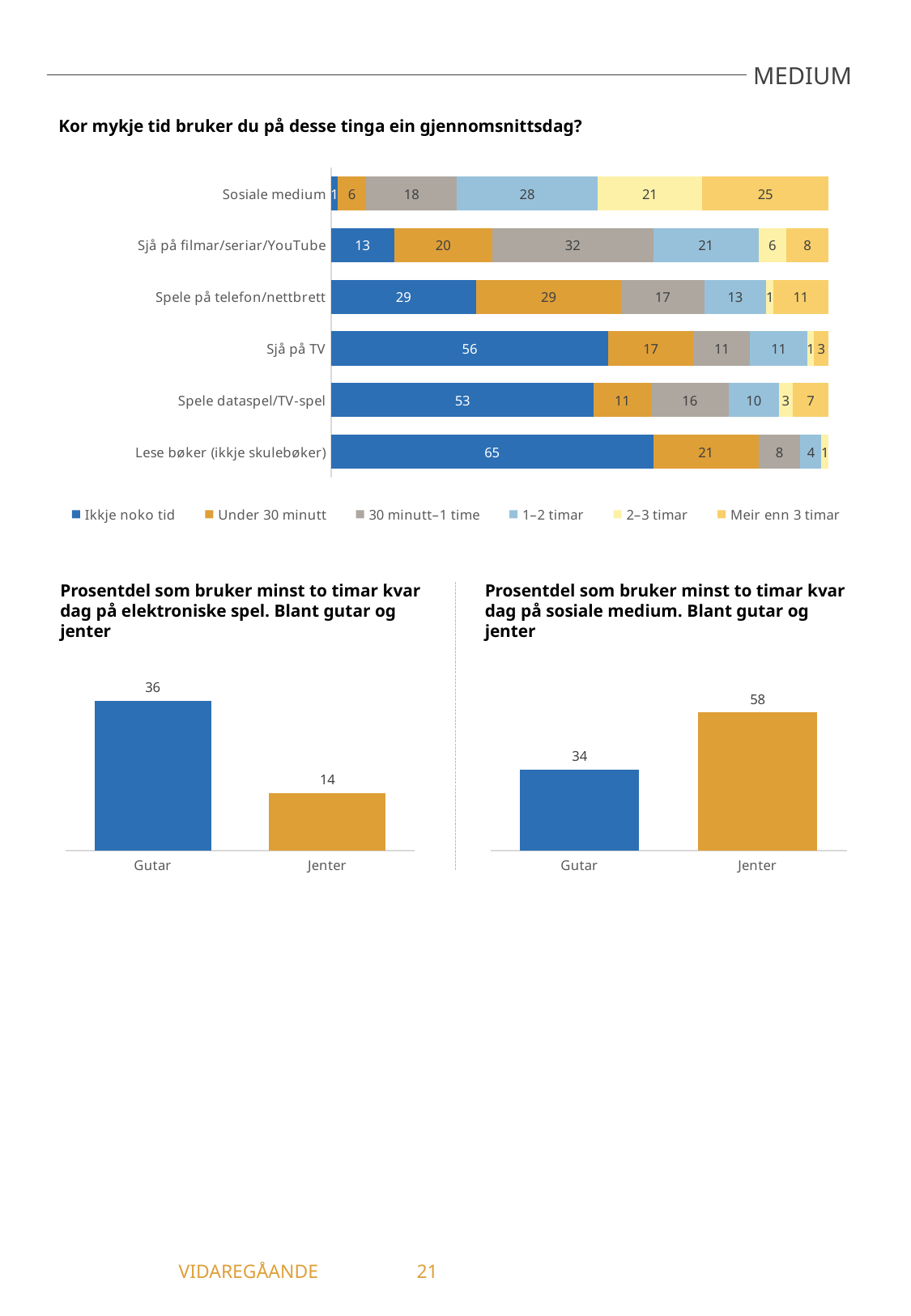
In the chart 'Kor mykje tid bruker du på desse tinga ein gjennomsnittsdag?', how many categories are shown? 6 In the chart 'Kor mykje tid bruker du på desse tinga ein gjennomsnittsdag?', which category has the highest value for 'Ikkje noko tid'? Lese bøker (ikkje skulebøker) What kind of chart is 'Prosentdel som bruker minst to timar kvar dag på elektroniske spel. Blant gutar og jenter'? Bar chart In the chart 'Prosentdel som bruker minst to timar kvar dag på sosiale medium. Blant gutar og jenter', what is the value for Jenter? 58 In the chart 'Kor mykje tid bruker du på desse tinga ein gjennomsnittsdag?', what is the value for 'Meir enn 3 timar' for 'Sosiale medium'? 25 In the chart 'Kor mykje tid bruker du på desse tinga ein gjennomsnittsdag?', how many series does the legend list? 6 In the chart 'Kor mykje tid bruker du på desse tinga ein gjennomsnittsdag?', which category has the lowest value for 'Ikkje noko tid'? Sosiale medium In the chart 'Kor mykje tid bruker du på desse tinga ein gjennomsnittsdag?', what is the value for 'Ikkje noko tid' for 'Lese bøker (ikkje skulebøker)'? 65 In the chart 'Kor mykje tid bruker du på desse tinga ein gjennomsnittsdag?', what is the value for '30 minutt–1 time' for 'Sjå på filmar/seriar/YouTube'? 32 In the chart 'Prosentdel som bruker minst to timar kvar dag på sosiale medium. Blant gutar og jenter', what is the difference between Jenter and Gutar? 24 In the chart 'Prosentdel som bruker minst to timar kvar dag på elektroniske spel. Blant gutar og jenter', what is the value for Gutar? 36 In the chart 'Kor mykje tid bruker du på desse tinga ein gjennomsnittsdag?', what is the difference between the 'Ikkje noko tid' values for 'Sjå på TV' and 'Spele dataspel/TV-spel'? 3